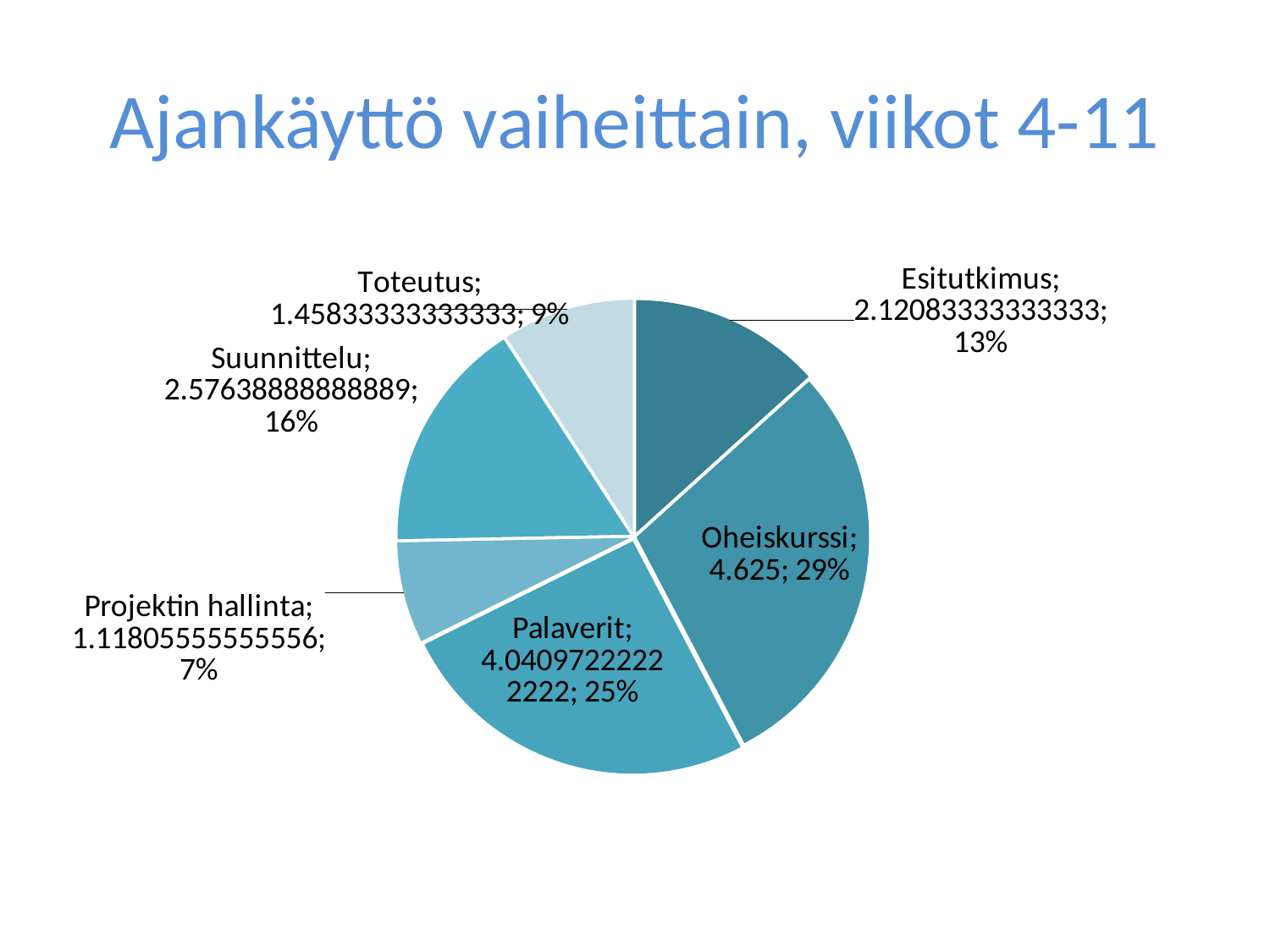
What is the value shown for Palaverit? 4.04097222222222 What is the difference in percentage share between Oheiskurssi and Palaverit? 4 percentage points How many slices does the pie chart have? 6 Which category has the smallest slice of the pie? Projektin hallinta What share of the pie does Oheiskurssi take? 29% What share of the pie does Projektin hallinta take? 7% What is the title of the chart? Ajankäyttö vaiheittain, viikot 4-11 What is the value shown for Suunnittelu? 2.57638888888889 Which category has the largest slice of the pie? Oheiskurssi Which is larger, the slice for Suunnittelu or the slice for Toteutus? Suunnittelu What kind of chart is shown on the slide? pie chart What is the value shown for Esitutkimus? 2.12083333333333